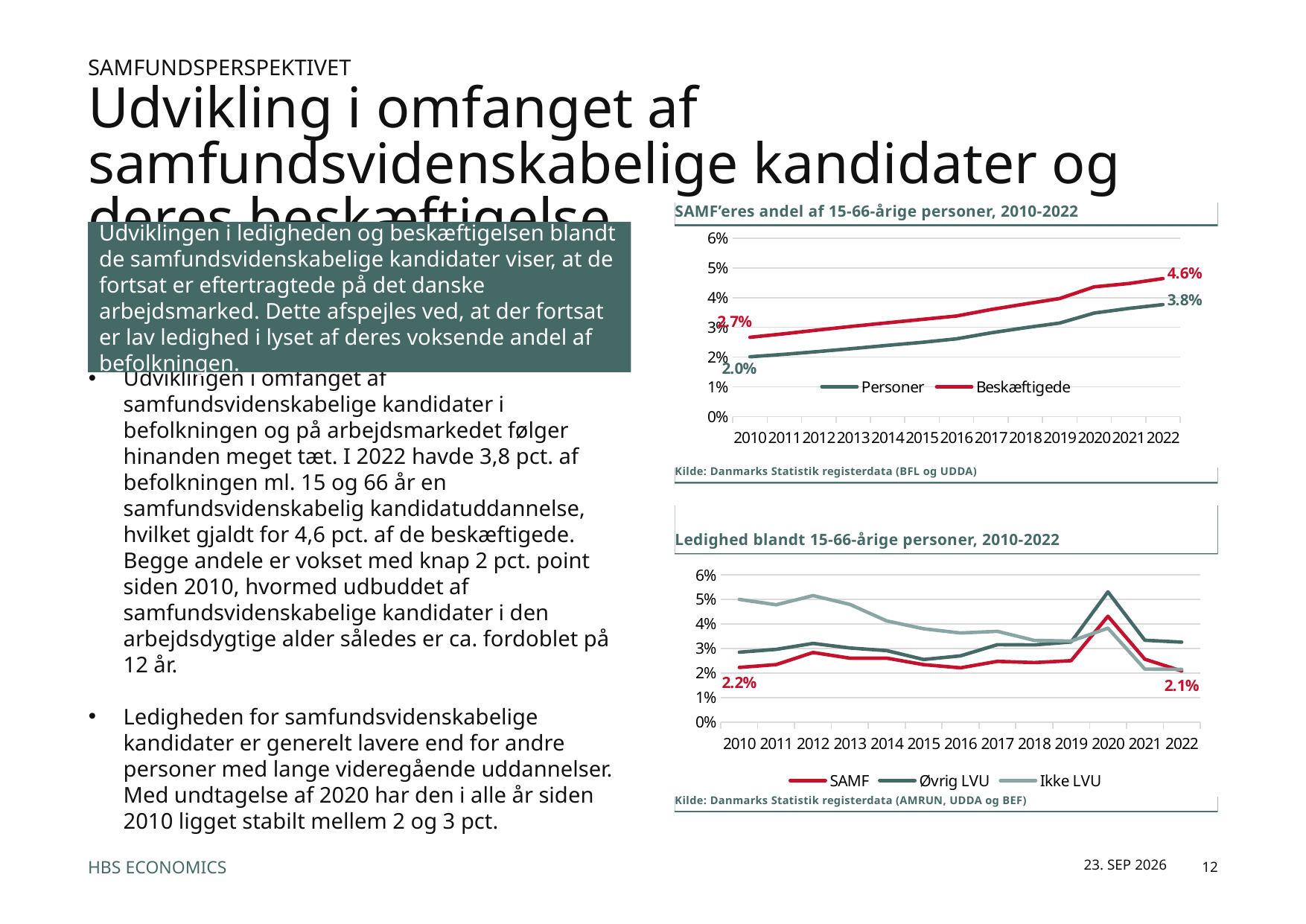
In the chart 'Ledighed blandt 15-66-årige personer, 2010-2022', what is the value for SAMF in 2022? 2.1% In the chart 'Ledighed blandt 15-66-årige personer, 2010-2022', is the value for Øvrig LVU in 2020 greater or less than 5%? greater In the chart 'SAMF'eres andel af 15-66-årige personer, 2010-2022', by how much did the Beskæftigede share increase from 2010 to 2022? 1.9 percentage points How many series does the legend of the chart 'SAMF'eres andel af 15-66-årige personer, 2010-2022' list? 2 In the chart 'SAMF'eres andel af 15-66-årige personer, 2010-2022', what is the value for Beskæftigede in 2010? 2.7% In the chart 'SAMF'eres andel af 15-66-årige personer, 2010-2022', what is the difference between Beskæftigede and Personer in 2022? 0.8 percentage points In the chart 'SAMF'eres andel af 15-66-årige personer, 2010-2022', what is the value for Beskæftigede in 2022? 4.6% In the chart 'Ledighed blandt 15-66-årige personer, 2010-2022', what is the value for SAMF in 2010? 2.2% In the chart 'SAMF'eres andel af 15-66-årige personer, 2010-2022', do the values rise or fall from 2010 to 2022? rise What kind of chart is 'Ledighed blandt 15-66-årige personer, 2010-2022'? line chart In the chart 'Ledighed blandt 15-66-årige personer, 2010-2022', in which year does the SAMF series reach its highest value? 2020 In the chart 'SAMF'eres andel af 15-66-årige personer, 2010-2022', what is the value for Personer in 2010? 2.0%